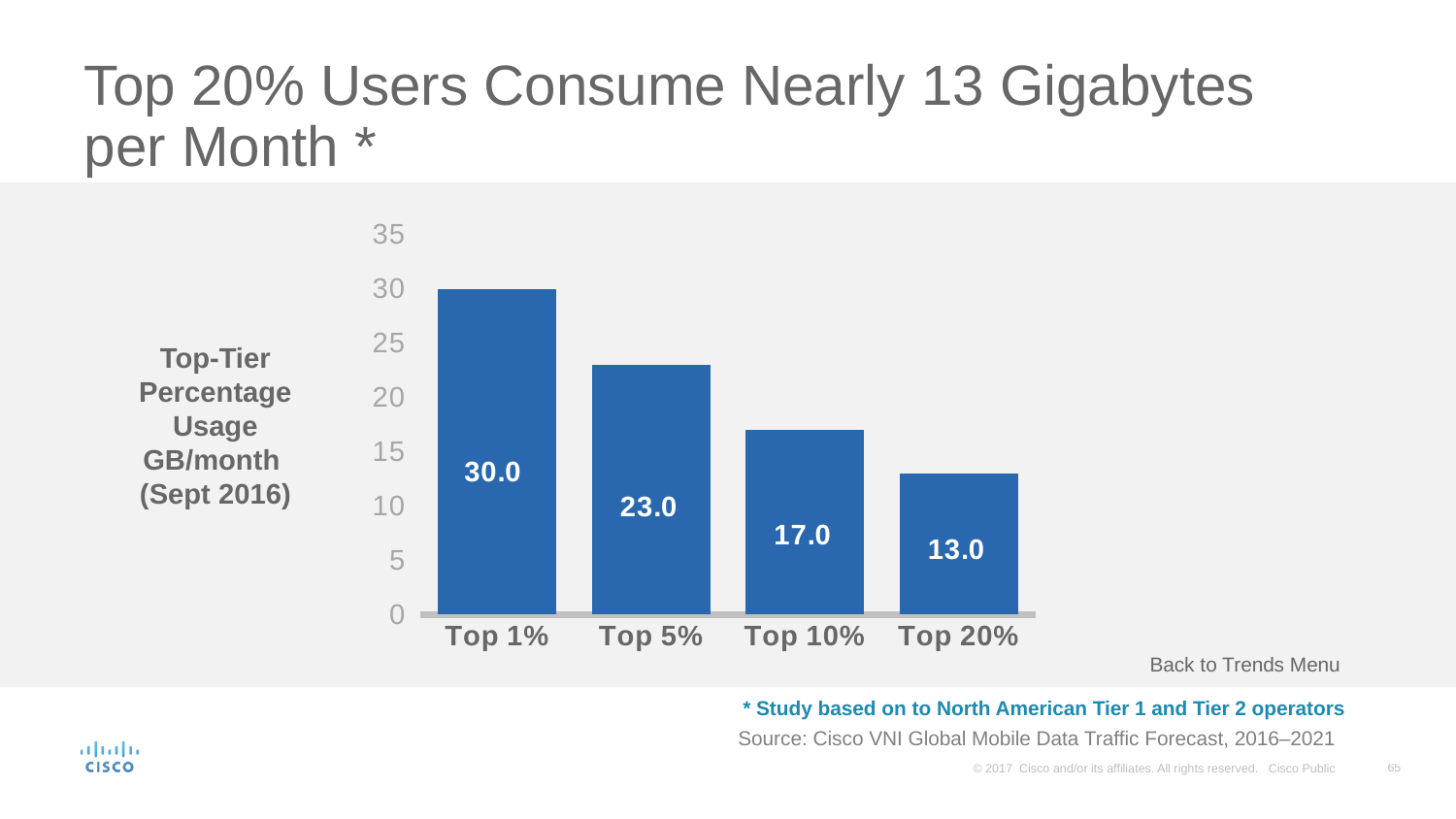
What is the value for Top 1%? 30.0 What is the difference between the values for Top 1% and Top 20%? 17.0 Which category has the highest value? Top 1% Which category has the lowest value? Top 20% What is the difference between the values for Top 5% and Top 10%? 6.0 What is the value for Top 5%? 23.0 How many categories are shown on the x axis? 4 Do the values rise or fall from Top 1% to Top 20% along the x axis? Fall What is the value for Top 20%? 13.0 What is the value for Top 10%? 17.0 Which is larger, the value for Top 5% or the value for Top 10%? Top 5% What kind of chart is shown on the slide? Bar chart